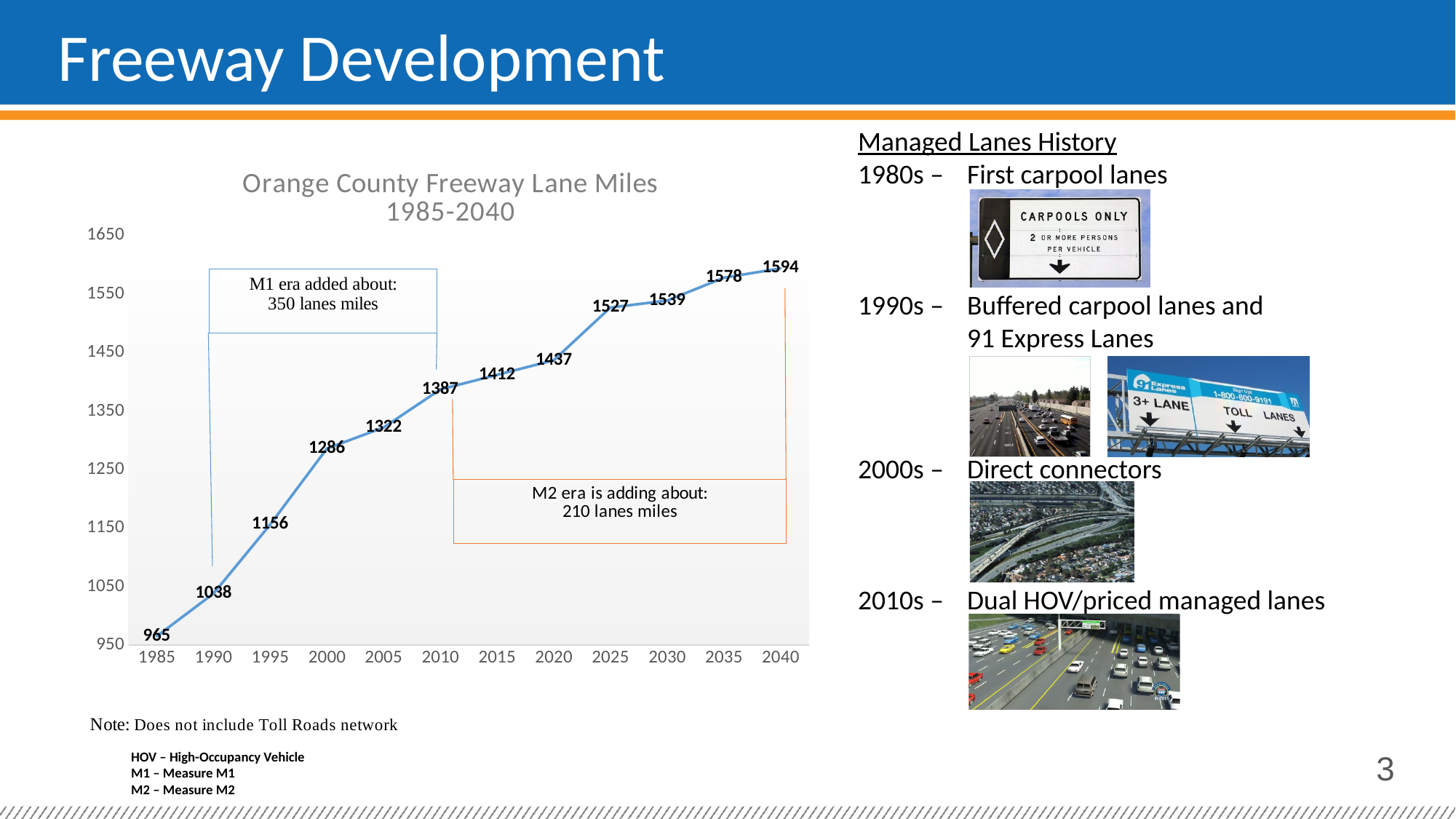
How many data points are plotted on the chart? 12 What is the title of the chart? Orange County Freeway Lane Miles 1985-2040 Which is larger, the value for 2000 or the value for 2005? 2005 What is the value of freeway lane miles in 2040? 1594 Which year has the highest value of freeway lane miles? 2040 What is the value of freeway lane miles in 2010? 1387 What type of chart is shown on the slide? line chart What is the difference in freeway lane miles between 2025 and 2020? 90 Which year has the lowest value of freeway lane miles? 1985 Do the values rise or fall from 1985 to 2040? rise What is the difference in freeway lane miles between 2040 and 1985? 629 What is the value of freeway lane miles in 1985? 965